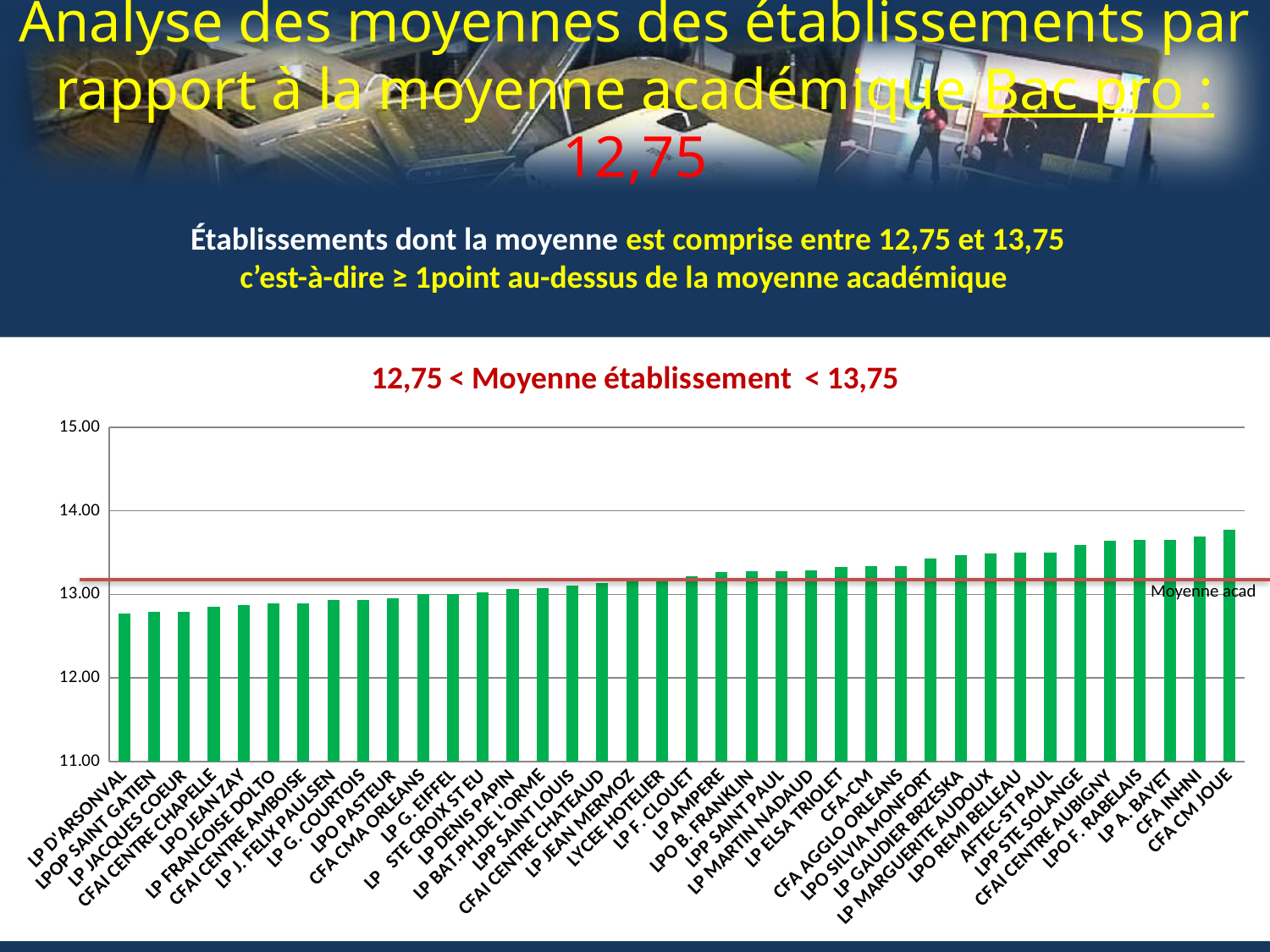
Is the value for CFA CM JOUE greater or less than 14.00? less What kind of chart is shown on the slide? bar chart Which establishment has the highest bar in the chart? CFA CM JOUE Is the value for LP D'ARSONVAL greater or less than 13.00? less Is the value for LP A. BAYET greater or less than 13.00? greater Do the bar values rise or fall from left to right along the x axis? rise Which establishment has the lowest bar in the chart? LP D'ARSONVAL Which is larger, the value for LP AMPERE or the value for LPO JEAN ZAY? LP AMPERE What is the title of the chart? 12,75 < Moyenne établissement < 13,75 How many establishments are plotted in the chart? 38 What label is shown on the red horizontal line in the chart? Moyenne acad